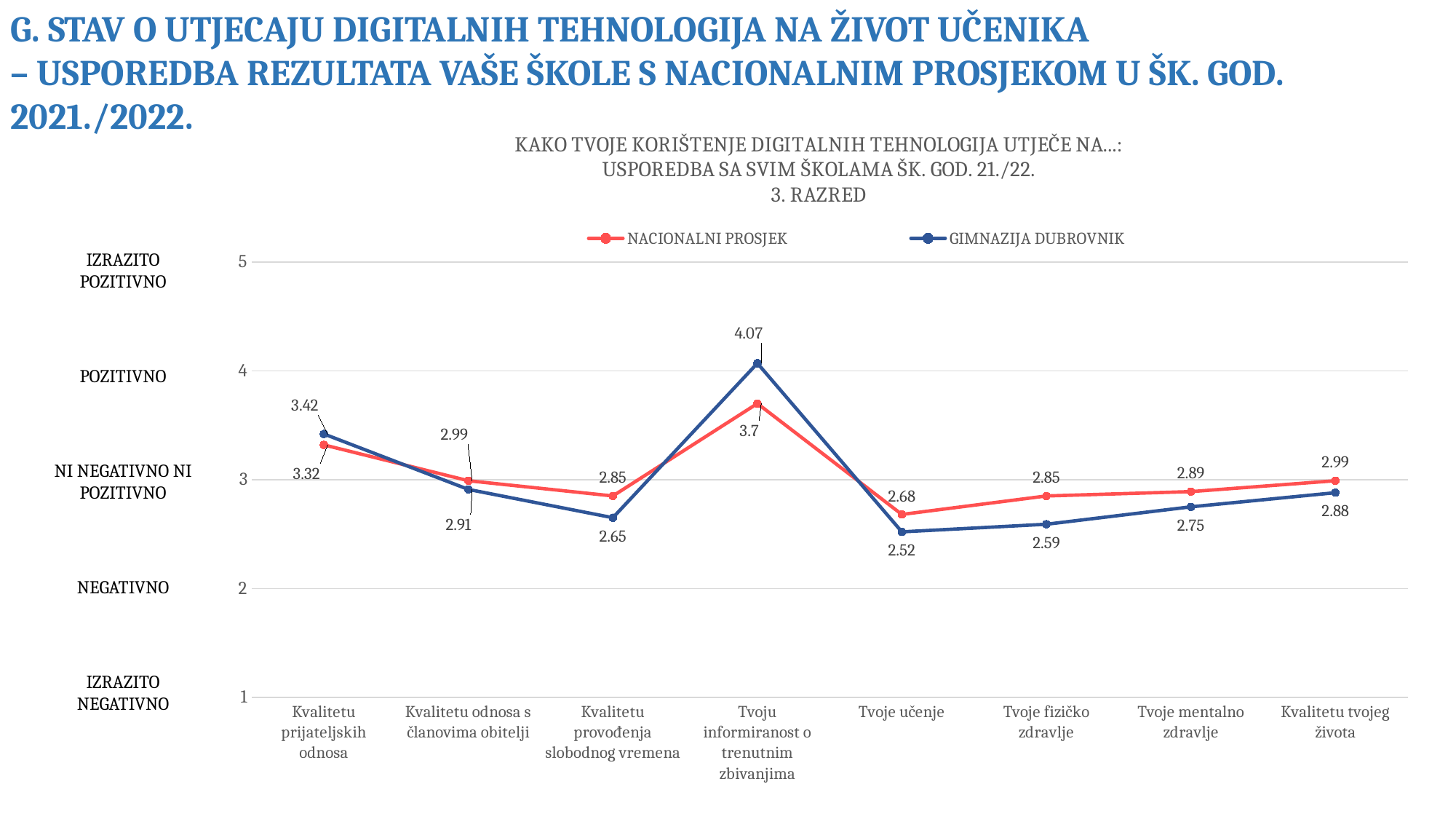
Which category has the lowest value for GIMNAZIJA DUBROVNIK? Tvoje učenje What is the value for NACIONALNI PROSJEK for 'Tvoje učenje'? 2.68 What is the difference between GIMNAZIJA DUBROVNIK and NACIONALNI PROSJEK for 'Tvoju informiranost o trenutnim zbivanjima'? 0.37 Which category has the highest value for GIMNAZIJA DUBROVNIK? Tvoju informiranost o trenutnim zbivanjima What is the value for GIMNAZIJA DUBROVNIK for 'Tvoje fizičko zdravlje'? 2.59 What type of chart is shown on the slide? line chart Is the value for NACIONALNI PROSJEK for 'Tvoju informiranost o trenutnim zbivanjima' greater or less than 4? less How many series does the legend list? 2 For 'Kvalitetu prijateljskih odnosa', which series has the larger value, NACIONALNI PROSJEK or GIMNAZIJA DUBROVNIK? GIMNAZIJA DUBROVNIK How many categories are shown on the x axis? 8 What is the value for GIMNAZIJA DUBROVNIK for 'Tvoju informiranost o trenutnim zbivanjima'? 4.07 Which colour is used for the NACIONALNI PROSJEK line? red